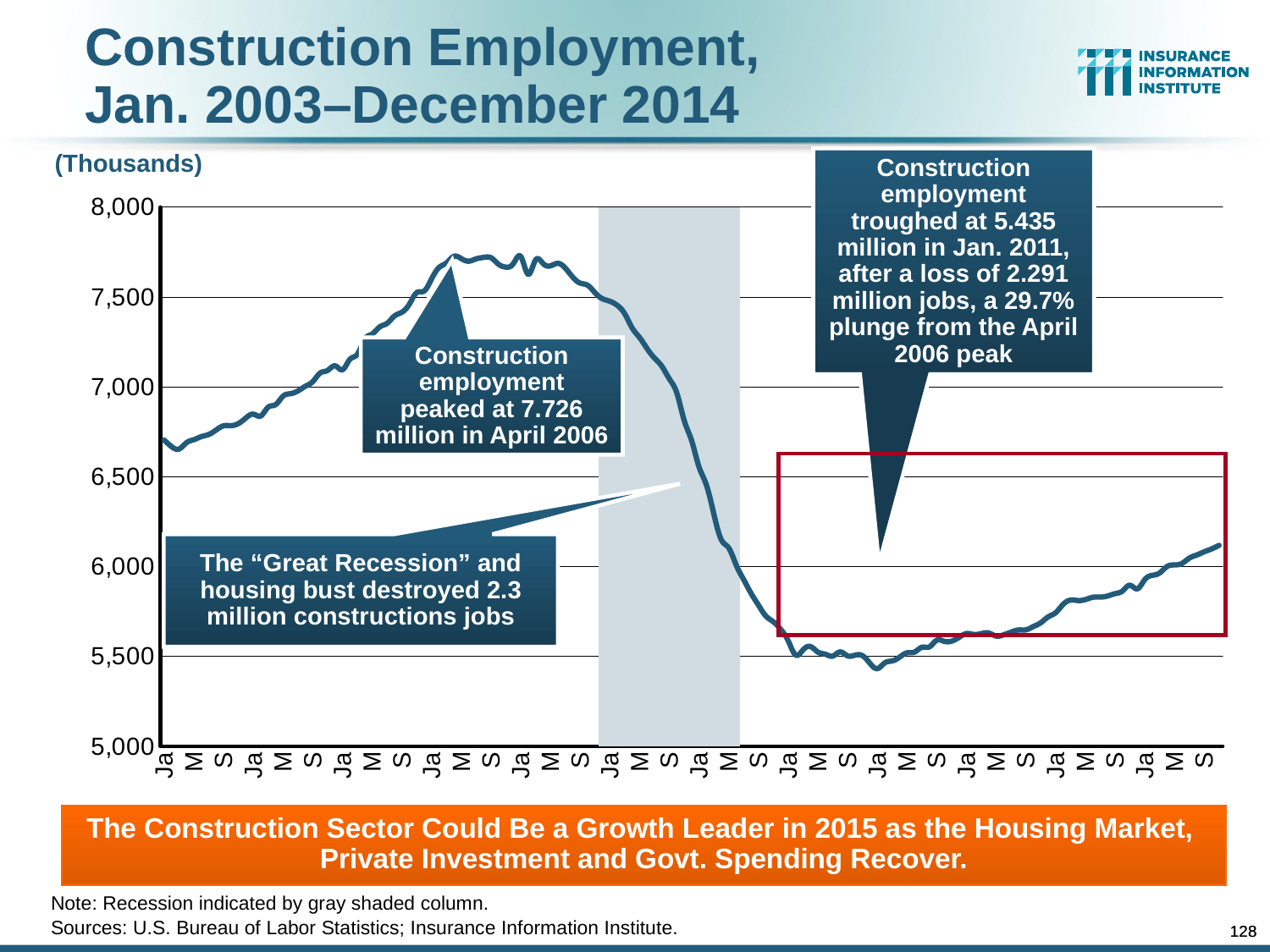
How many jobs were lost between the April 2006 peak and the Jan. 2011 trough, as stated on the slide? 2.291 million Does construction employment rise or fall from Jan. 2011 to the end of 2014? rise Is construction employment at the start of the series (Jan. 2003) greater or less than 6,500 thousand? greater In what units is the y axis of the chart expressed? Thousands Does construction employment rise or fall between the April 2006 peak and the Jan. 2011 trough? fall Is construction employment at the end of the series (late 2014) greater or less than 6,500 thousand? less What does the gray shaded column on the chart indicate? Recession Which is higher: construction employment in April 2006 or in Jan. 2011? April 2006 What kind of chart is shown on the slide? line chart What percentage plunge from the April 2006 peak does the slide state for the Jan. 2011 trough? 29.7% According to the callout, at what level did construction employment peak in April 2006? 7.726 million According to the callout, at what level did construction employment trough in Jan. 2011? 5.435 million